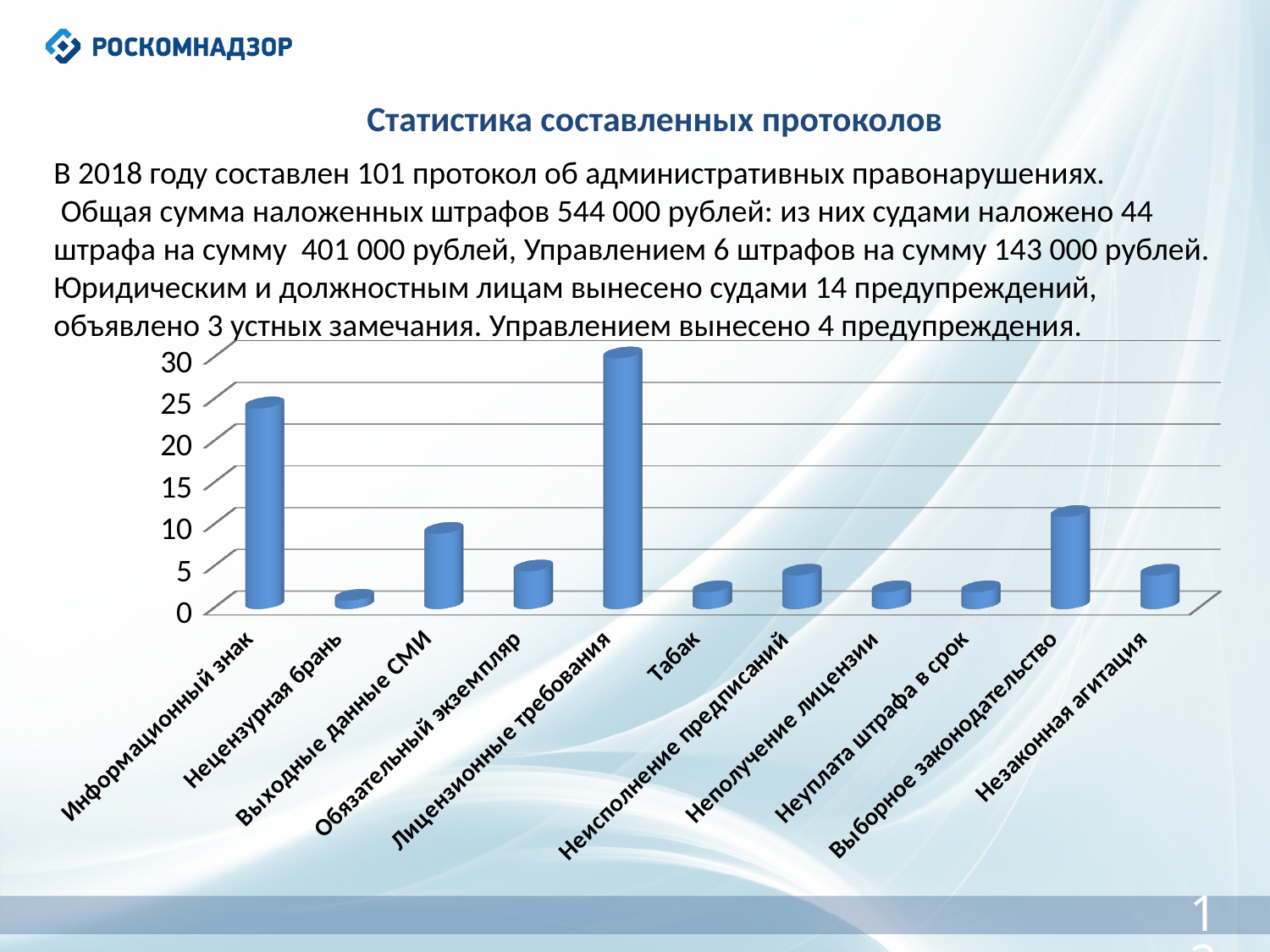
How many categories are shown on the x axis of the chart? 11 Is the value for Информационный знак greater or less than 20? greater What is the title shown above the chart on the slide? Статистика составленных протоколов Is the value for Лицензионные требования greater or less than 25? greater Which is larger, the value for Информационный знак or the value for Выборное законодательство? Информационный знак Which is larger, the value for Выходные данные СМИ or the value for Табак? Выходные данные СМИ Is the value for Нецензурная брань greater or less than 5? less What is the highest tick value shown on the vertical axis of the chart? 30 Which category has the highest value in the chart? Лицензионные требования What kind of chart is shown on the slide? bar chart